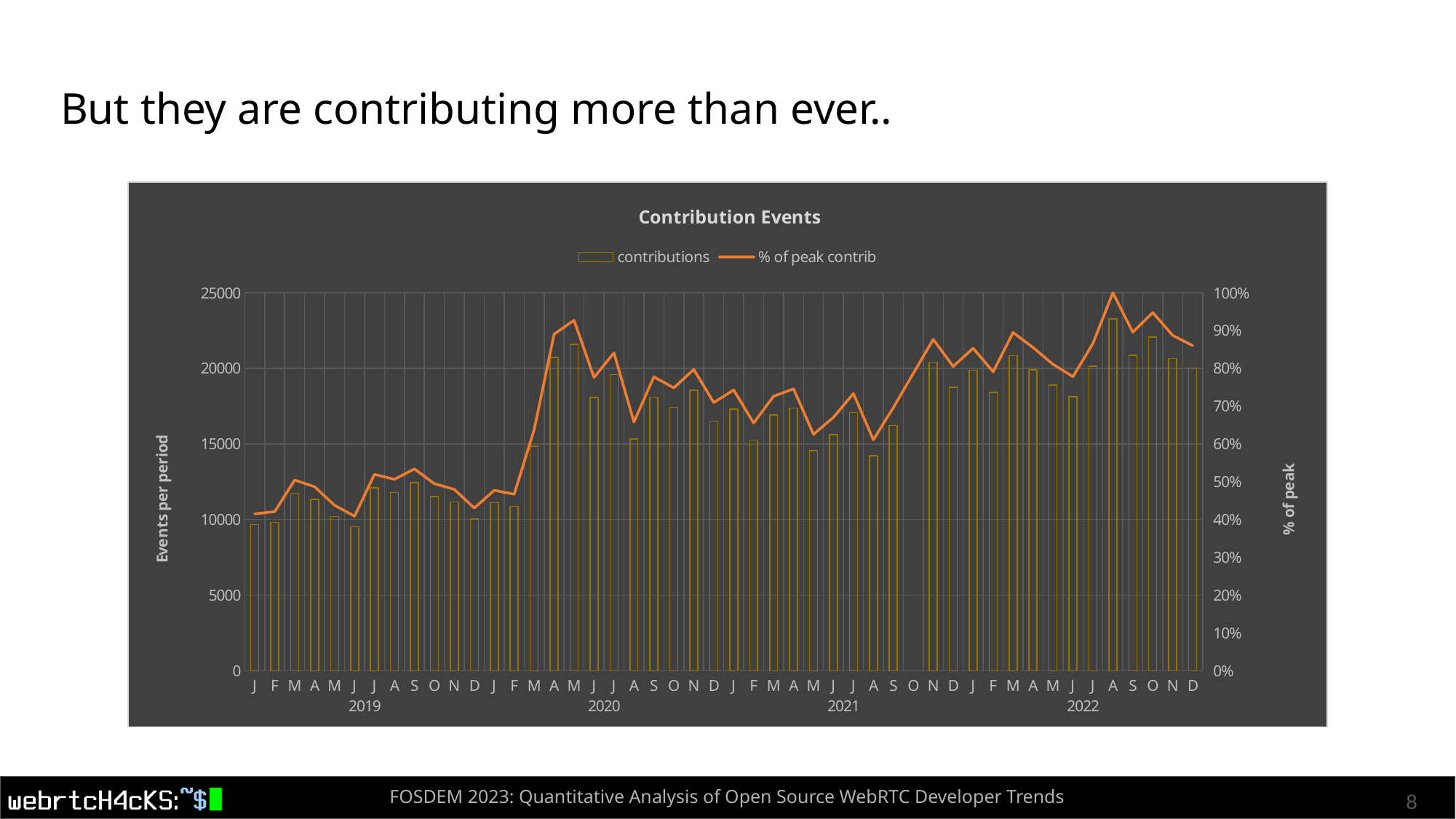
What is the % of peak contrib value for August 2022? 100% In which month and year does the % of peak contrib line reach 100%? August 2022 How many monthly bars are plotted in the Contribution Events chart? 47 Is the contributions value for May 2020 greater or less than 20000? greater How many series does the legend of the Contribution Events chart list? 2 Is the % of peak contrib value for December 2019 greater or less than 50%? less Is the contributions value for January 2019 greater or less than 10000? less What are the two series named in the legend of the Contribution Events chart? contributions and % of peak contrib Which month has the higher contributions value, May 2019 or May 2020? May 2020 What kind of chart is shown on the slide? Combined bar and line chart How many years are covered on the x axis of the Contribution Events chart? 4 What is the title of the chart on the slide? Contribution Events